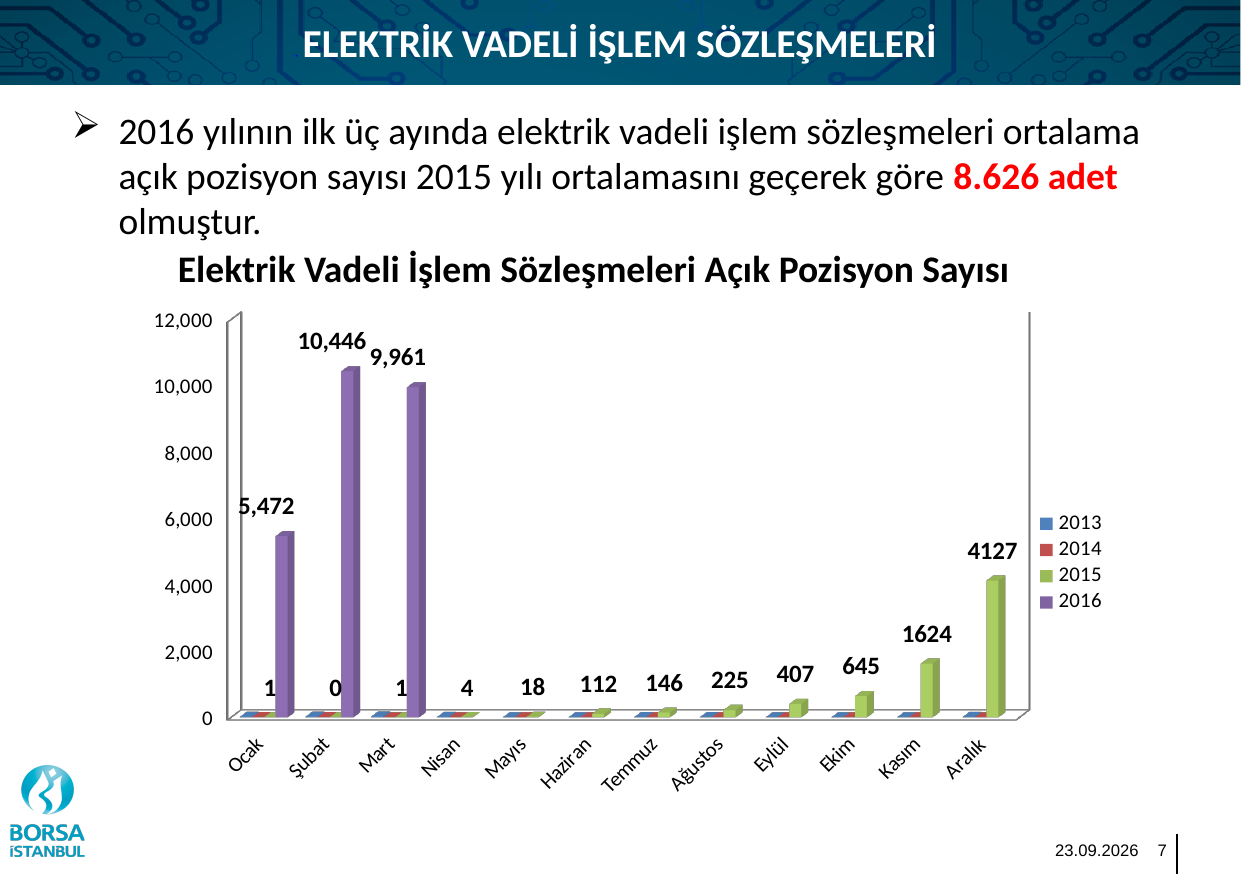
What is the value for 2016 in Ocak? 5,472 What is the value for 2015 in Aralık? 4127 What is the value for 2016 in Mart? 9,961 What is the value for 2016 in Şubat? 10,446 What is the value for 2015 in Ekim? 645 How many series does the legend list? 4 In which month is the 2016 value highest? Şubat How many months are shown on the x axis? 12 Do the 2015 values rise or fall from Haziran to Aralık? rise What is the value for 2015 in Kasım? 1624 What is the difference between the 2016 values for Şubat and Mart? 485 Which is larger: the 2015 value for Aralık or the 2016 value for Ocak? 2016 value for Ocak